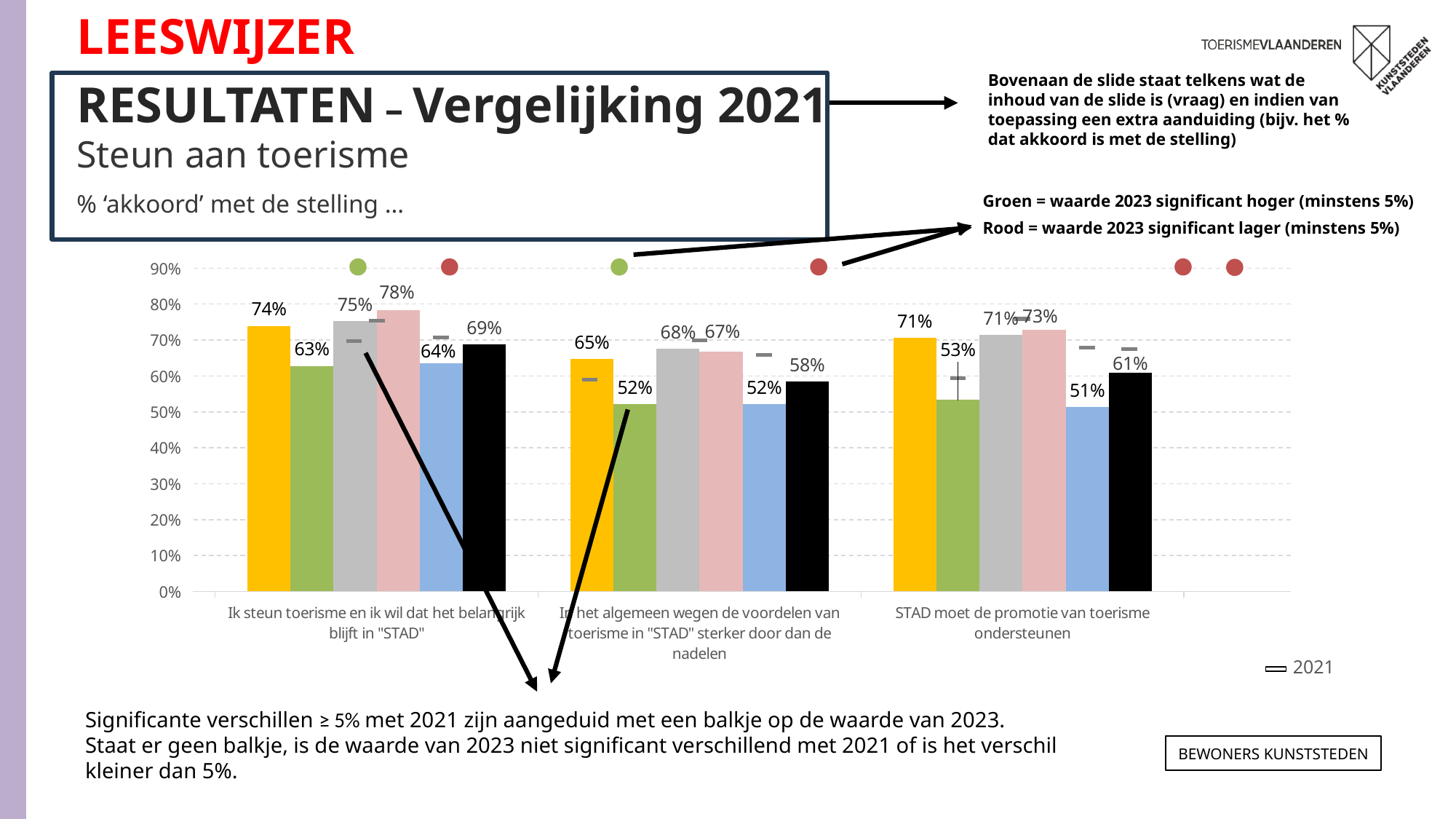
Which coloured bar has the highest value for the statement "Ik steun toerisme en ik wil dat het belangrijk blijft in 'STAD'"? pink (78%) What is the value of the yellow bar for the statement "Ik steun toerisme en ik wil dat het belangrijk blijft in 'STAD'"? 74% What type of chart is shown on the slide? bar chart How many statement categories are shown along the x axis of the chart? 3 What is the difference between the yellow bar and the green bar for the statement "In het algemeen wegen de voordelen van toerisme in 'STAD' sterker door dan de nadelen"? 13 percentage points Which year is named in the chart legend next to the dash marker? 2021 What is the value of the pink bar for the statement "Ik steun toerisme en ik wil dat het belangrijk blijft in 'STAD'"? 78% Which coloured bar has the lowest value for the statement "STAD moet de promotie van toerisme ondersteunen"? blue (51%) For the statement "STAD moet de promotie van toerisme ondersteunen", which is larger: the yellow bar or the black bar? the yellow bar (71%) Is the value of the green bar for the statement "Ik steun toerisme en ik wil dat het belangrijk blijft in 'STAD'" greater or less than 60%? greater What is the value of the black bar for the statement "In het algemeen wegen de voordelen van toerisme in 'STAD' sterker door dan de nadelen"? 58% What is the value of the blue bar for the statement "STAD moet de promotie van toerisme ondersteunen"? 51%